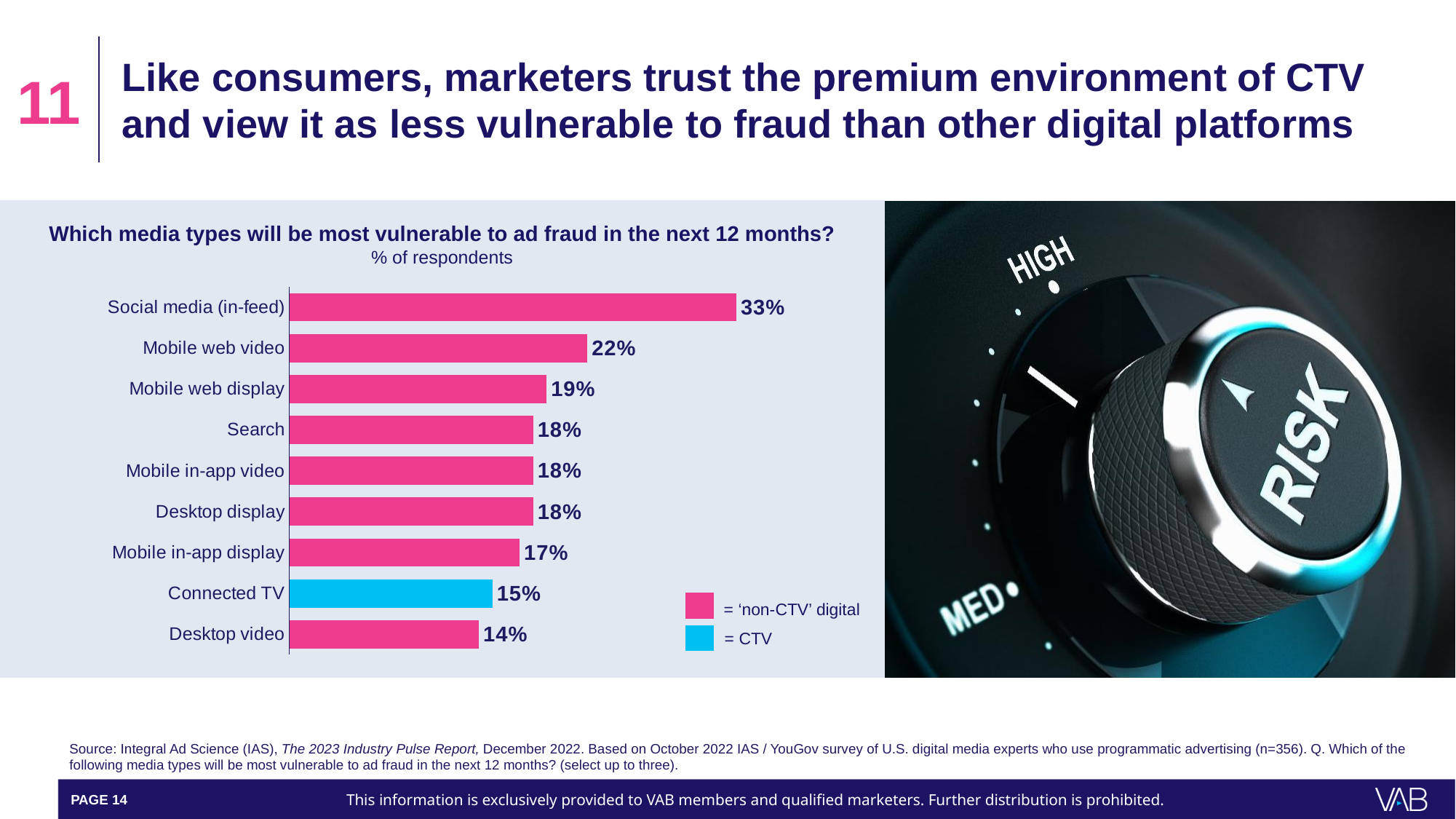
Which media type is shown in a different colour (blue) from the others? Connected TV What percentage is shown for Mobile web video? 22% What kind of chart is used to show the media types? Bar chart Which media type has the highest percentage of respondents? Social media (in-feed) Which media type has the lowest percentage of respondents? Desktop video What percentage of respondents said Social media (in-feed) will be most vulnerable to ad fraud? 33% What is the value shown for Connected TV? 15% What is the difference in percentage points between Mobile web video and Mobile web display? 3 What is the difference in percentage points between Social media (in-feed) and Connected TV? 18 How many entries does the legend list? 2 Which has a higher value, Mobile in-app display or Desktop video? Mobile in-app display How many media types are shown in the chart? 9